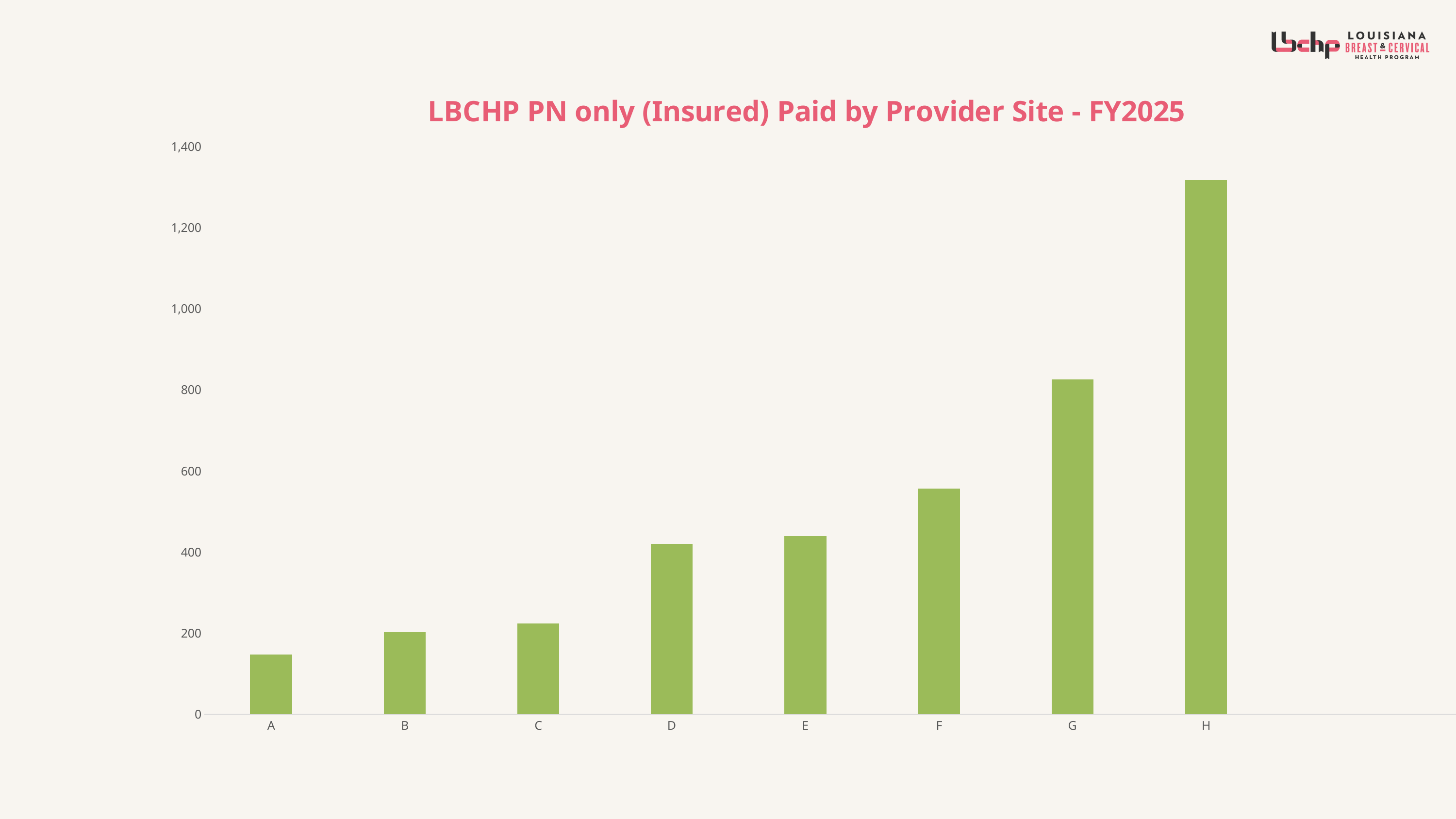
Do the values rise or fall moving from site A to site H along the x axis? rise What is the title of the chart? LBCHP PN only (Insured) Paid by Provider Site - FY2025 Is the value for site F greater or less than 600? less Which provider site has the lowest value? A Is the value for site H greater or less than 1,200? greater Which has the larger value, site G or site H? H Which has the larger value, site A or site B? B What kind of chart is shown on the slide? bar chart Is the value for site E greater or less than 400? greater Which provider site has the highest value? H How many provider sites are shown on the x axis? 8